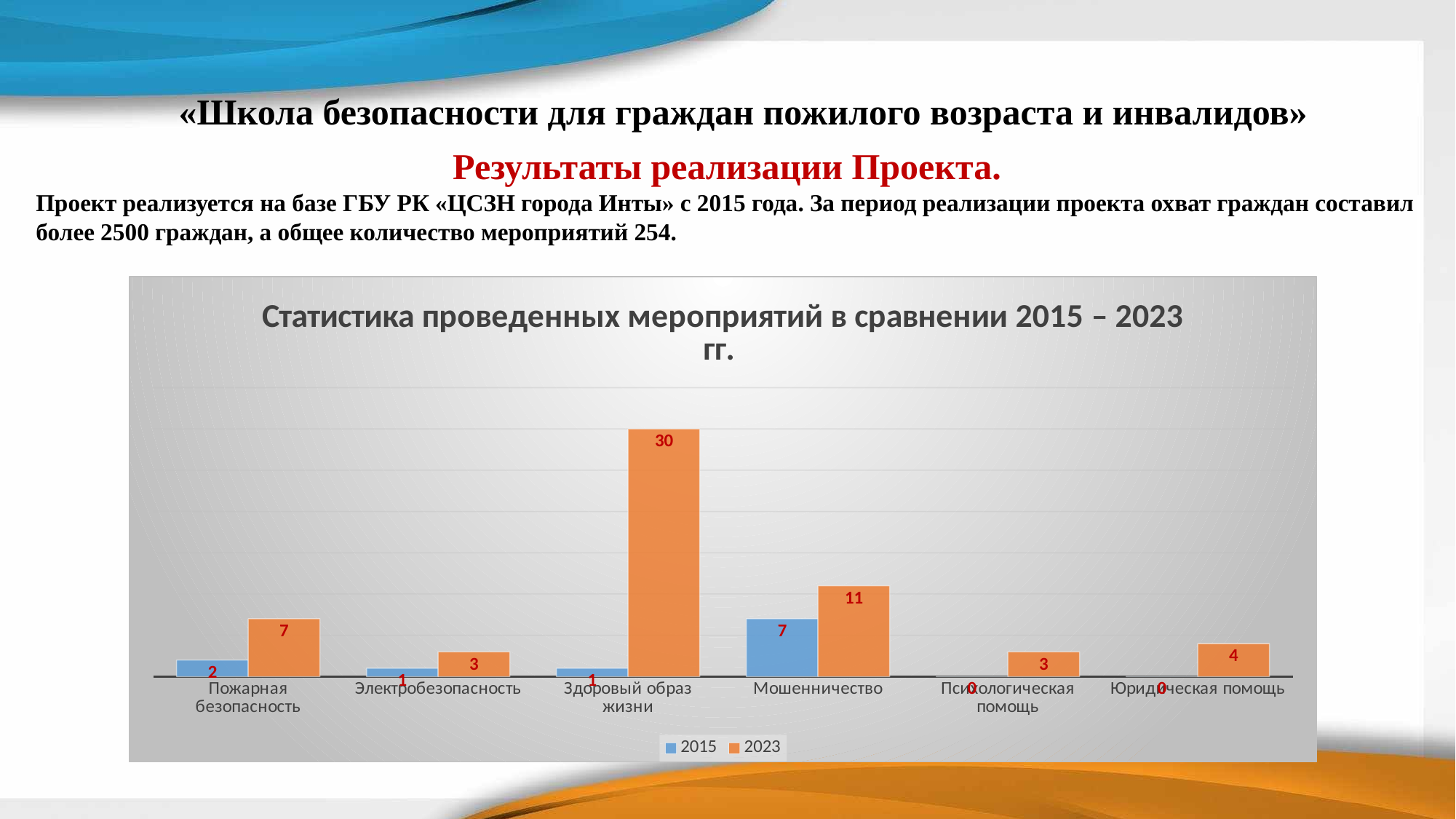
What is the difference between the 2023 and 2015 values for Здоровый образ жизни? 29 Which category has the highest value in the 2023 series? Здоровый образ жизни Which category has the highest value in the 2015 series? Мошенничество What is the value for Мошенничество in the 2015 series? 7 What is the value for Здоровый образ жизни in the 2023 series? 30 Which is larger: the 2023 value for Пожарная безопасность or the 2023 value for Электробезопасность? Пожарная безопасность What is the difference between the 2023 and 2015 values for Мошенничество? 4 How many series does the legend list? 2 What is the value for Юридическая помощь in the 2023 series? 4 What kind of chart is shown on the slide? Bar chart How many categories are shown on the x axis? 6 What is the value for Пожарная безопасность in the 2023 series? 7